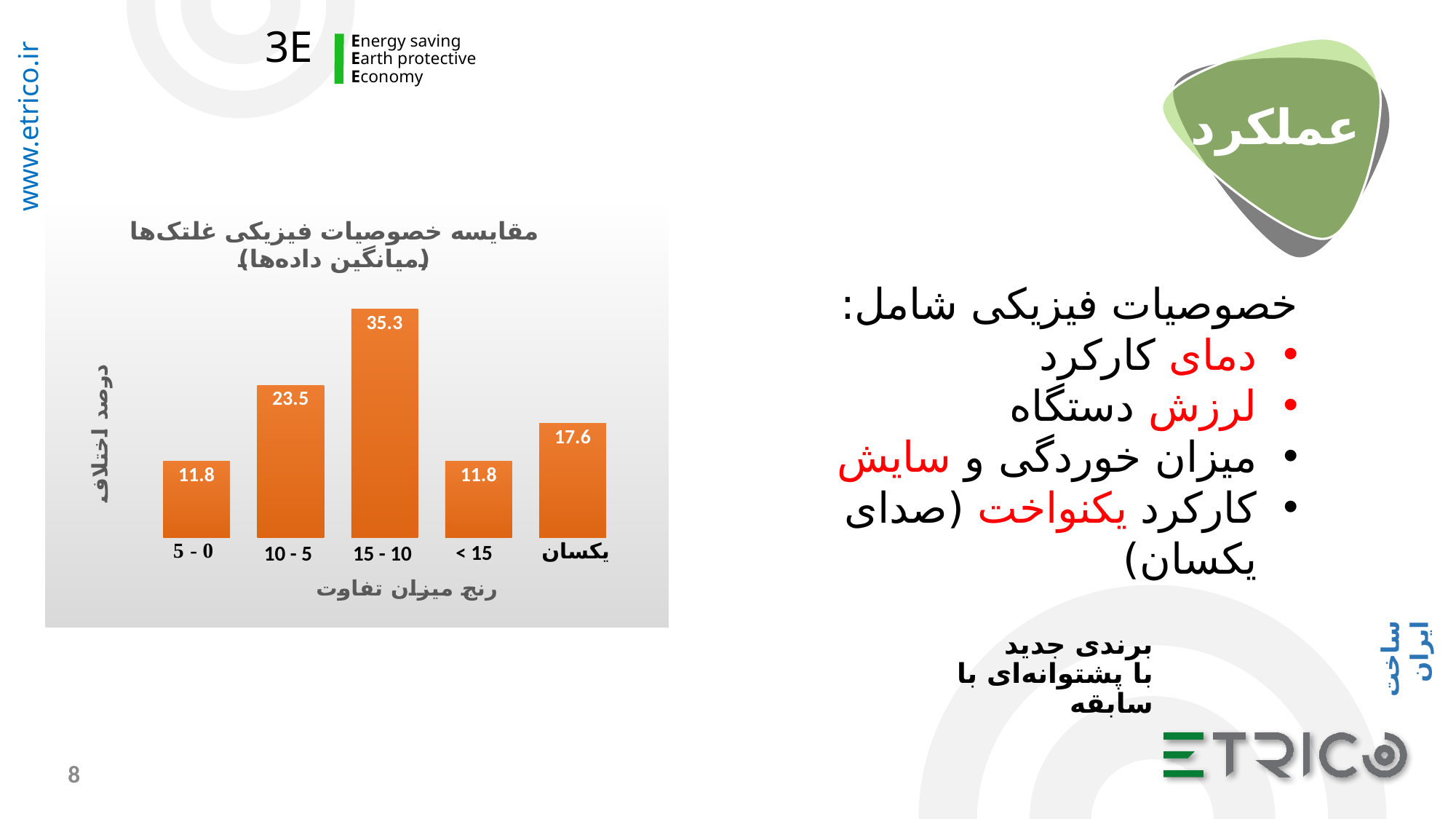
What is the difference between the values for "15 - 10" and "10 - 5"? 11.8 What is the lowest value shown on the chart? 11.8 What is the total of all five bar values? 100 Which category has the highest value? 15 - 10 What is the value of the bar labelled "5 - 0"? 11.8 What is the label of the vertical axis? درصد اختلاف What is the value of the bar labelled "15 - 10"? 35.3 What type of chart is shown on the slide? bar chart What is the value of the bar labelled "یکسان"? 17.6 How many bars (categories) does the chart show? 5 What is the value of the bar labelled "10 - 5"? 23.5 Which is larger, the value for "یکسان" or the value for "< 15"? یکسان